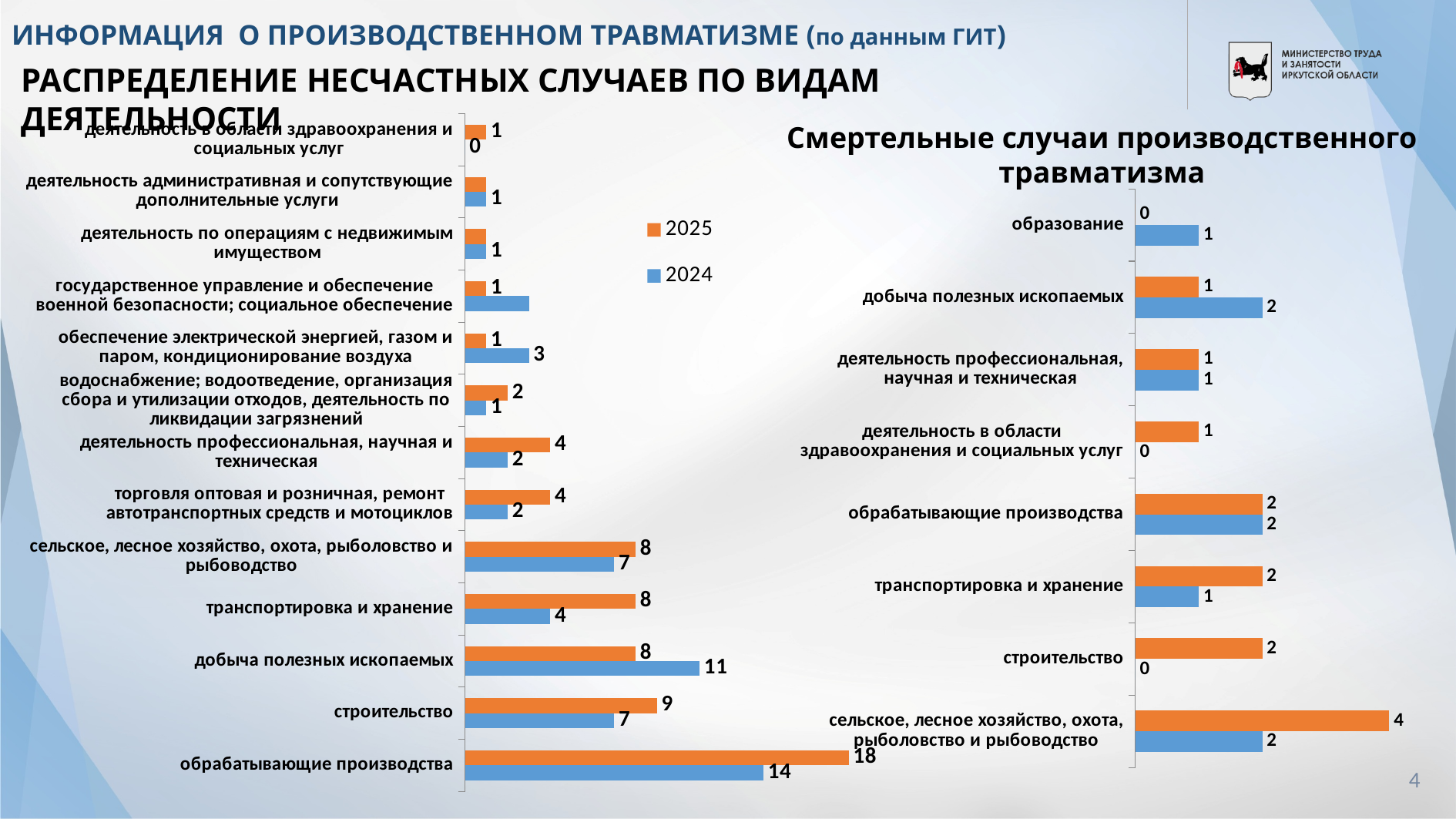
On the right chart (Смертельные случаи производственного травматизма), what is the 2024 value for строительство? 0 What type of chart is the right chart (Смертельные случаи производственного травматизма)? bar chart On the left chart (Распределение несчастных случаев по видам деятельности), how many categories are shown? 13 On the left chart (Распределение несчастных случаев по видам деятельности), which category has the highest 2025 value? обрабатывающие производства On the left chart (Распределение несчастных случаев по видам деятельности), which is larger for строительство: the 2025 value or the 2024 value? 2025 On the left chart (Распределение несчастных случаев по видам деятельности), what is the difference between the 2025 and 2024 values for транспортировка и хранение? 4 How many series does the legend list? 2 On the left chart (Распределение несчастных случаев по видам деятельности), what is the 2024 value for добыча полезных ископаемых? 11 On the left chart (Распределение несчастных случаев по видам деятельности), what is the 2025 value for обрабатывающие производства? 18 Which colour represents the 2024 series in the legend? blue On the right chart (Смертельные случаи производственного травматизма), what is the 2025 value for сельское, лесное хозяйство, охота, рыболовство и рыбоводство? 4 On the right chart (Смертельные случаи производственного травматизма), how many categories are shown? 8